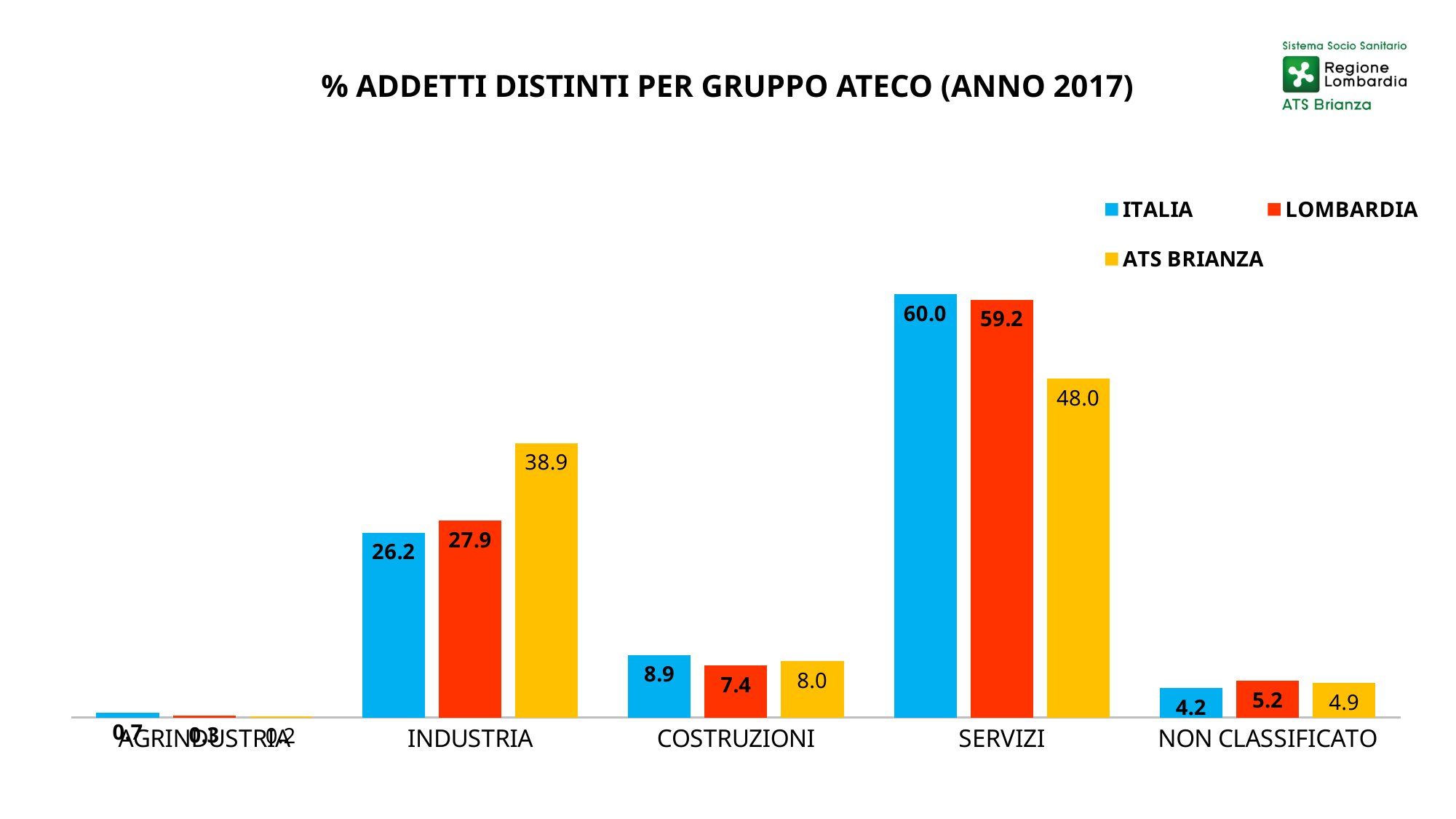
What is the difference between the ITALIA and ATS BRIANZA values in the SERVIZI category? 12.0 What is the value for ATS BRIANZA in the INDUSTRIA category? 38.9 What is the value for ATS BRIANZA in the NON CLASSIFICATO category? 4.9 In the COSTRUZIONI category, which is larger: the value for ITALIA or the value for ATS BRIANZA? ITALIA What kind of chart is shown on the slide? Bar chart In the INDUSTRIA category, which is larger: the value for ITALIA or the value for LOMBARDIA? LOMBARDIA How many categories are shown on the x axis? 5 Which category has the highest value for the ITALIA series? SERVIZI How many series does the legend list? 3 What is the difference between the ATS BRIANZA and ITALIA values in the INDUSTRIA category? 12.7 What is the value for ITALIA in the SERVIZI category? 60.0 What is the value for LOMBARDIA in the COSTRUZIONI category? 7.4